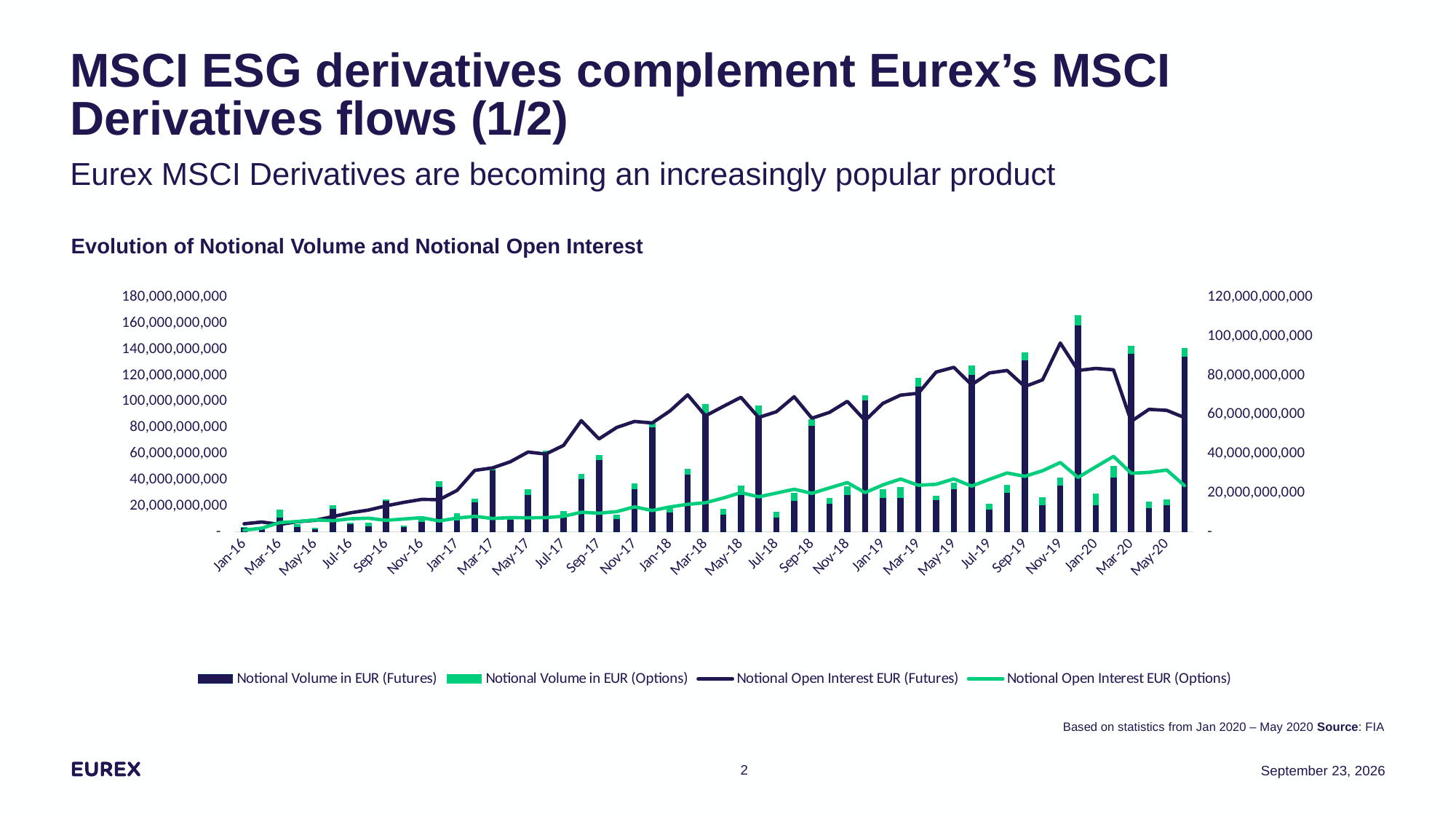
What is the last month label on the x axis? May-20 What is the highest value shown on the left vertical axis? 180,000,000,000 What kind of chart is shown on the slide? A combination bar and line chart Is the total notional volume bar for Jan-16 greater or less than 20,000,000,000? less Which is larger, the total notional volume bar for Jan-16 or for May-20? May-20 How many month labels are printed along the x axis? 27 Which line is higher across the chart, Notional Open Interest EUR (Futures) or Notional Open Interest EUR (Options)? Notional Open Interest EUR (Futures) What is the title of the chart? Evolution of Notional Volume and Notional Open Interest Do the notional volume bars generally rise or fall from Jan-16 to 2019? Rise How many series does the chart legend list? 4 Is the tallest notional volume bar on the chart greater or less than 80,000,000,000? greater What is the first month label on the x axis? Jan-16